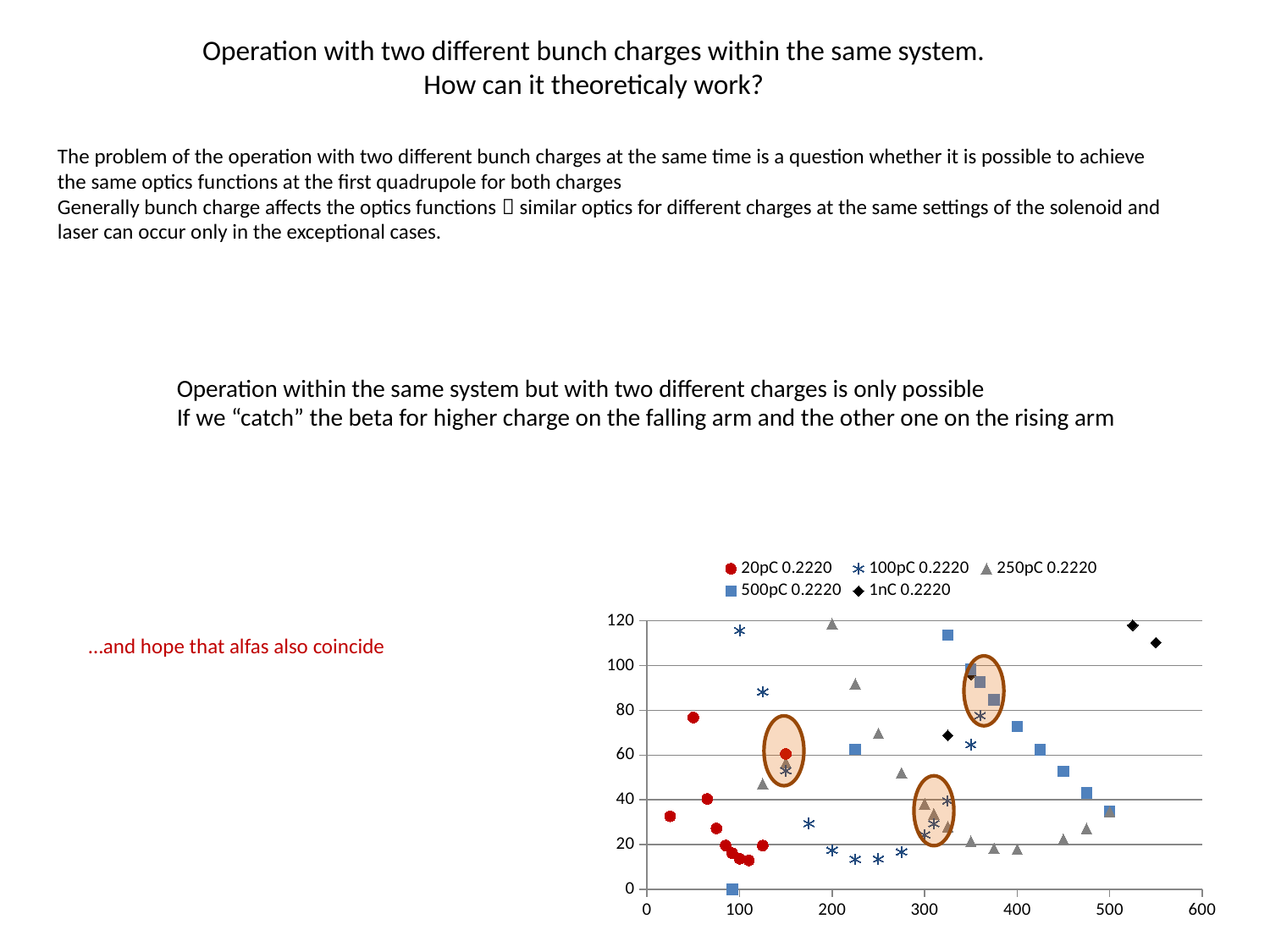
Is the value of the 1nC 0.2220 point at x = 525 greater or less than 100? greater Which series in the chart is plotted with red circle markers? 20pC 0.2220 Which is larger: the 500pC 0.2220 value at x = 325 or the 500pC 0.2220 value at x = 500? x = 325 Is the value of the 500pC 0.2220 point at x = 500 greater or less than 60? less How many series does the chart legend list? 5 Is the value of the 100pC 0.2220 point at x = 225 greater or less than 20? less Which is larger: the 20pC 0.2220 value at x = 50 or the 20pC 0.2220 value at x = 100? x = 50 What kind of chart is shown on the slide? scatter chart Which series in the chart is plotted with black diamond markers? 1nC 0.2220 Do the 500pC 0.2220 values rise or fall as x increases from 325 to 500? fall